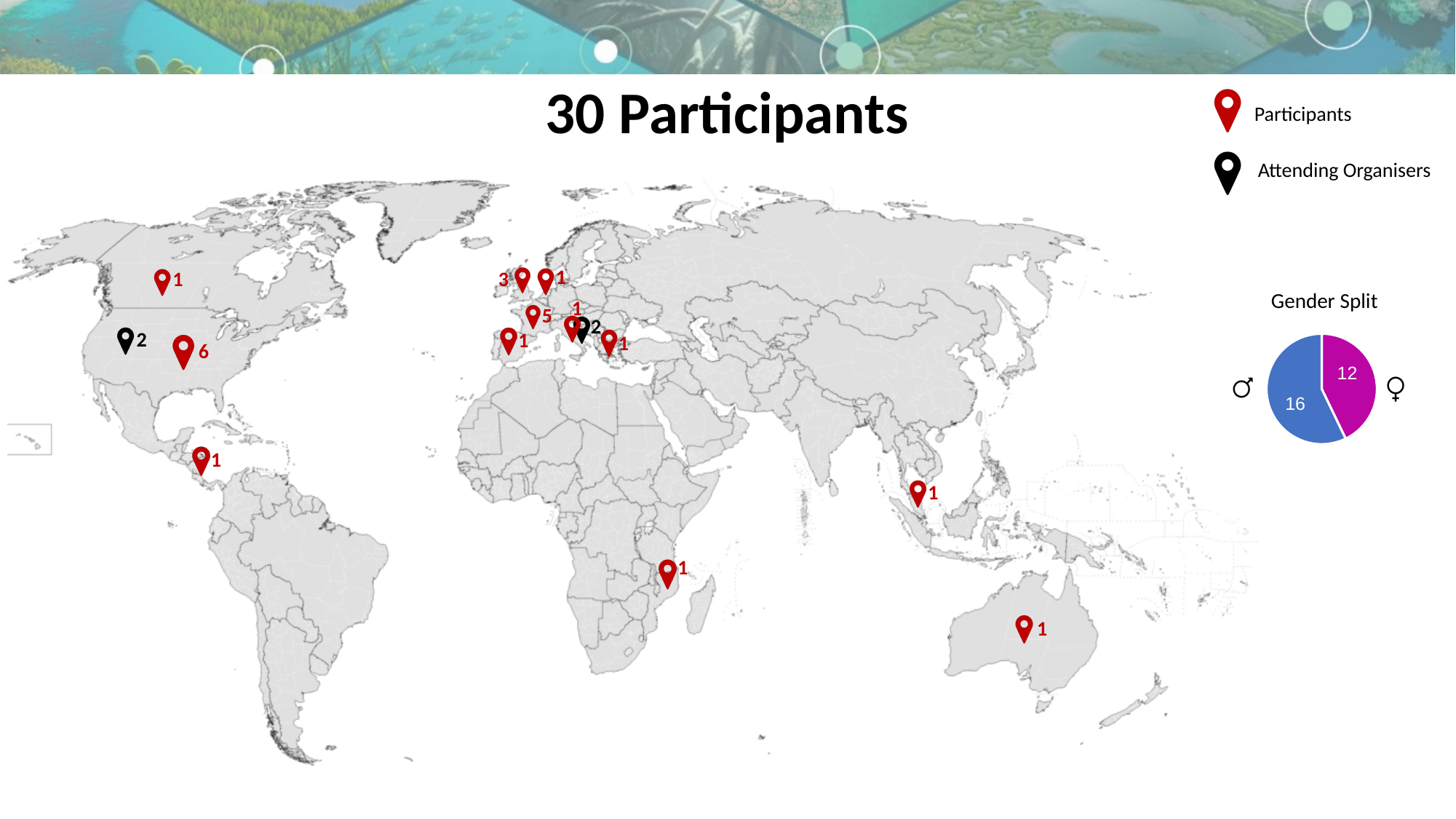
What colour is the female slice in the Gender Split pie chart? magenta In the Gender Split pie chart, what is the value for the male slice? 16 In the Gender Split pie chart, what is the value for the female slice? 12 In the Gender Split pie chart, which slice is larger, male or female? male What kind of chart is the Gender Split chart? pie chart In the Gender Split pie chart, which gender has the largest slice? male How many slices does the Gender Split pie chart have? 2 In the Gender Split pie chart, what is the difference between the male and female values? 4 What is the total of the two values shown in the Gender Split pie chart? 28 In the Gender Split pie chart, which gender has the smallest slice? female What is the title of the pie chart on the slide? Gender Split